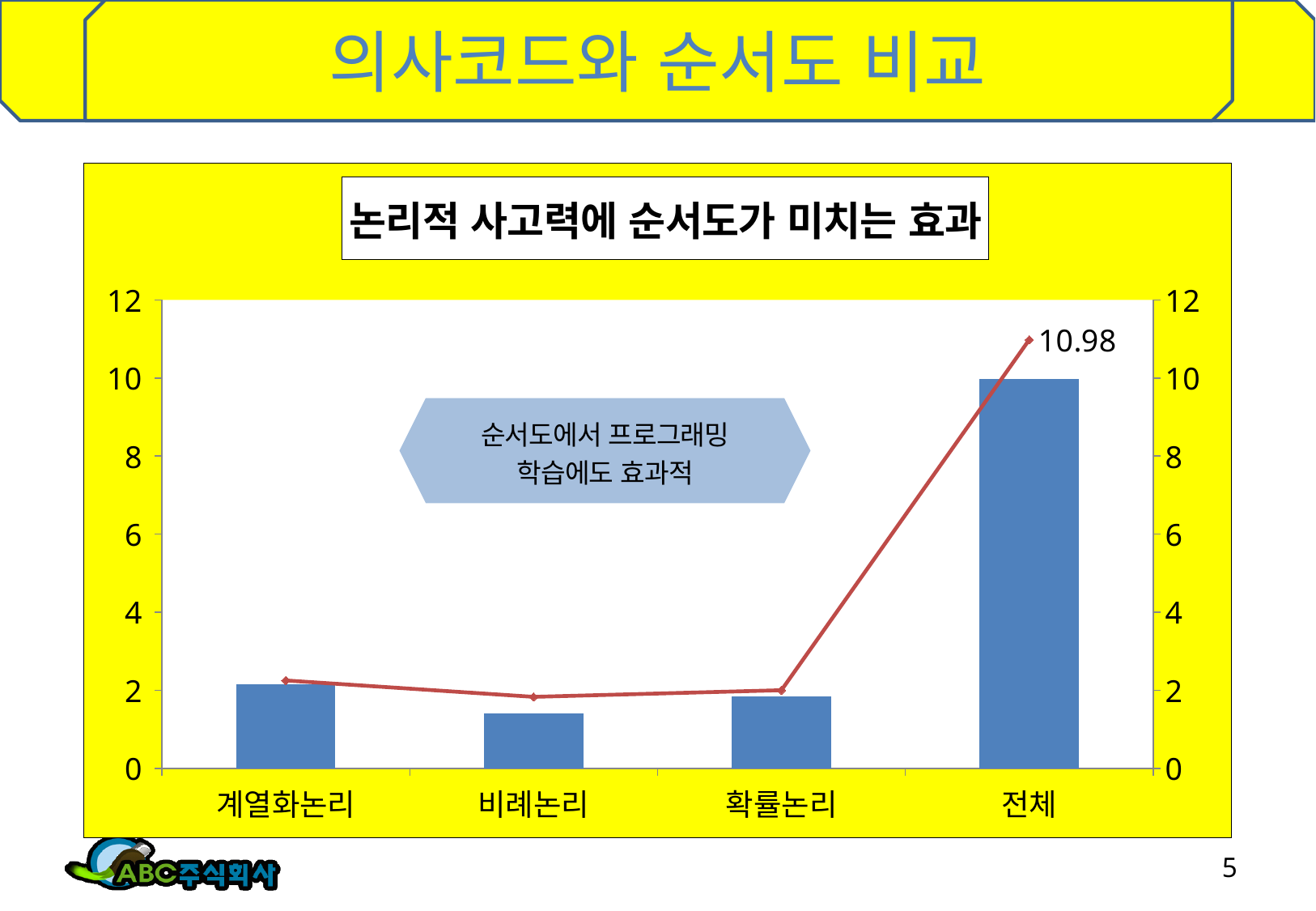
Is the bar value for 비례논리 greater or less than 2? less What is the title of the chart? 논리적 사고력에 순서도가 미치는 효과 Is the bar value for 전체 greater or less than 8? greater What text is written in the callout shape inside the chart? 순서도에서 프로그래밍 학습에도 효과적 Which category has the tallest bar? 전체 What kind of chart is shown on the slide? bar chart with a line How many categories are shown on the x axis of the chart? 4 Does the line rise or fall from 확률논리 to 전체? rise What value is labelled on the line at 전체? 10.98 Is the bar value for 확률논리 greater or less than 4? less Which has the larger bar, 전체 or 계열화논리? 전체 Which category has the shortest bar? 비례논리